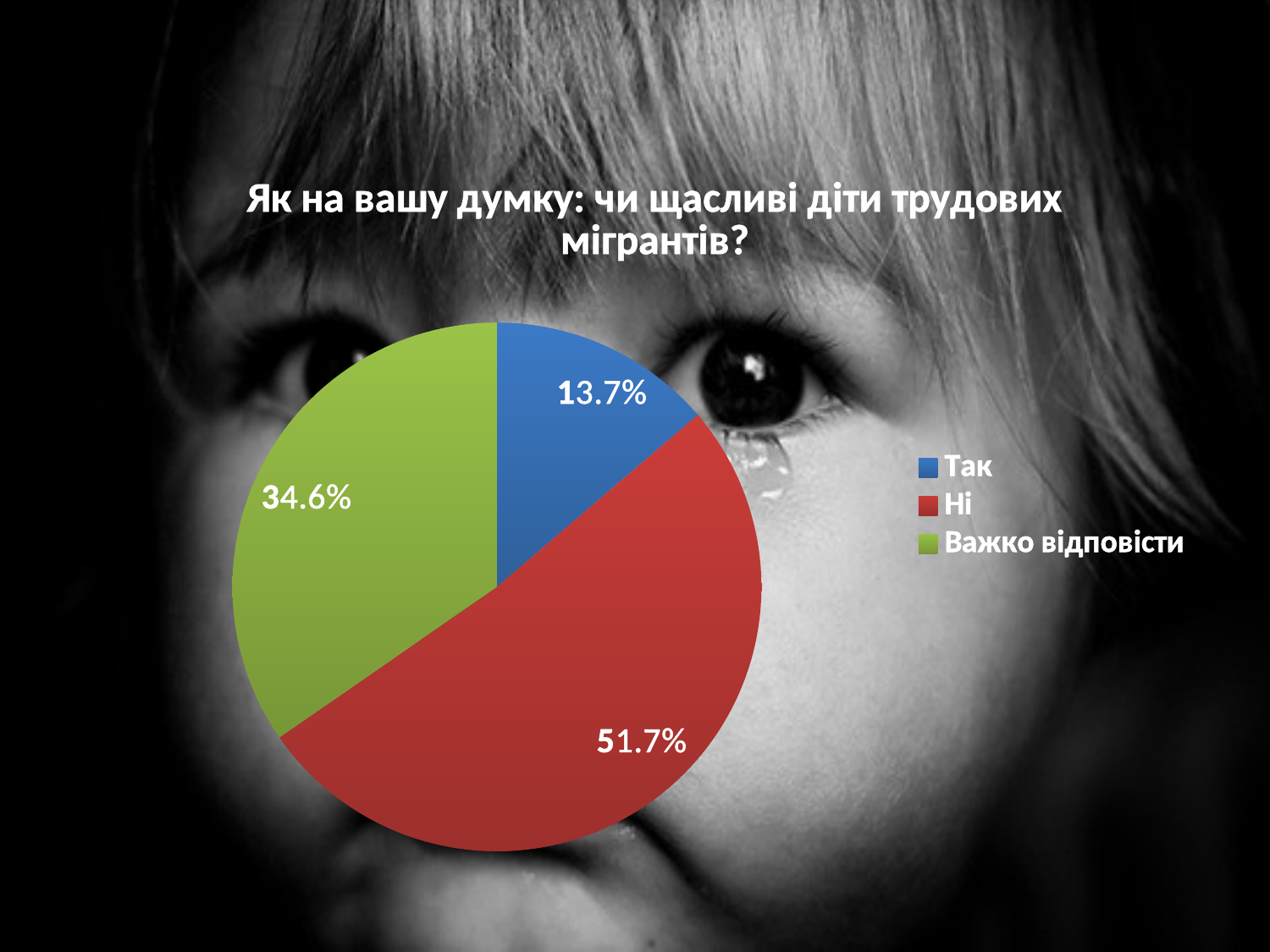
What is the difference between the values for "Важко відповісти" and "Так"? 20.9% What is the value for "Важко відповісти"? 34.6% What is the title of the chart? Як на вашу думку: чи щасливі діти трудових мігрантів? What is the difference between the values for "Ні" and "Так"? 38.0% How many slices does the pie chart have? 3 What colour is the slice for "Ні"? red Which category has the smallest share of the pie? Так Which category has the largest share of the pie? Ні What is the value for "Так"? 13.7% Which is larger, the value for "Важко відповісти" or the value for "Так"? Важко відповісти What kind of chart is shown on the slide? pie chart What is the value for "Ні"? 51.7%